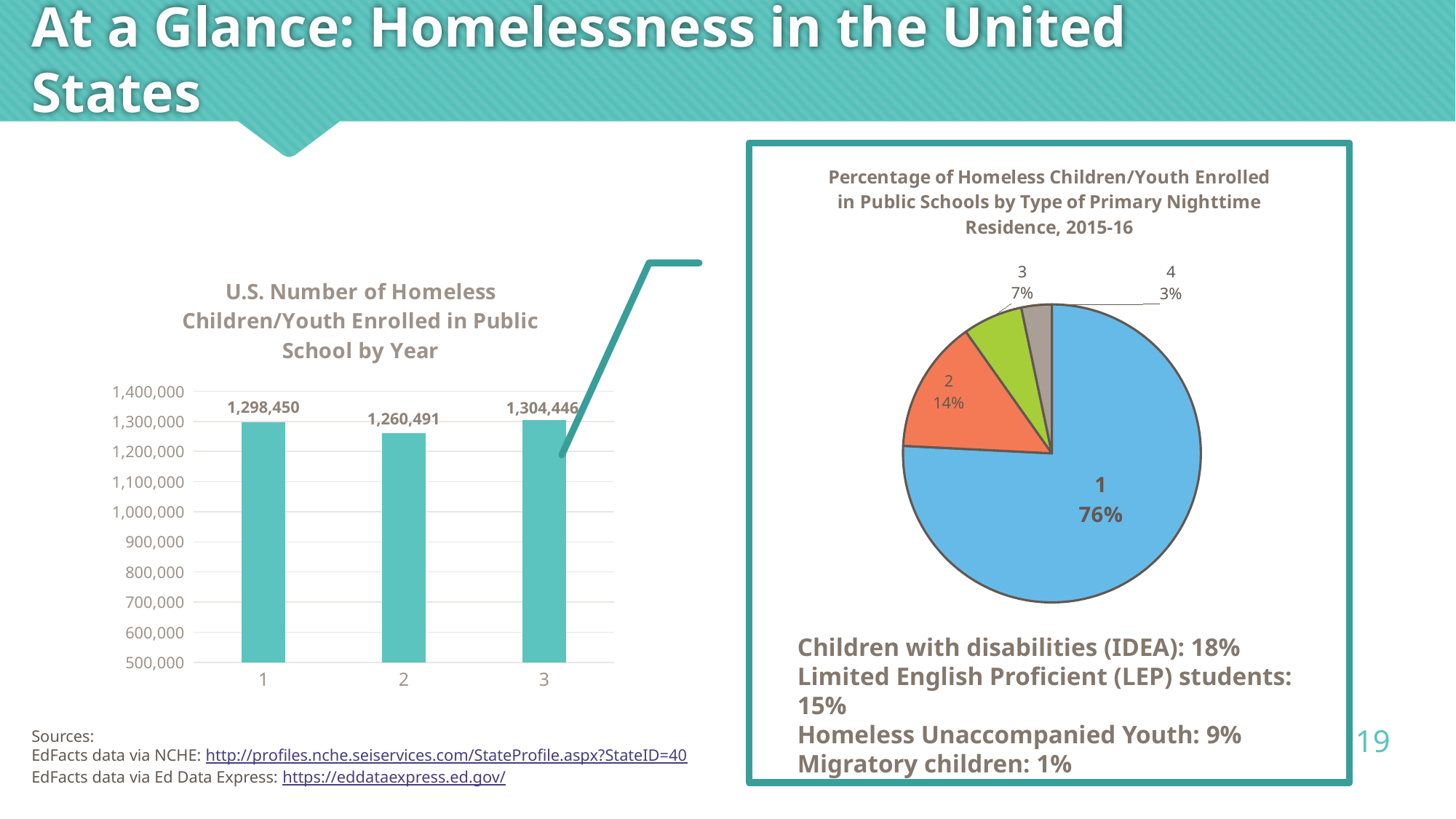
In the bar chart 'U.S. Number of Homeless Children/Youth Enrolled in Public School by Year', what is the value for category 2? 1,260,491 In the bar chart 'U.S. Number of Homeless Children/Youth Enrolled in Public School by Year', how many bars are plotted? 3 What type of chart is the chart on the left of the slide? Bar chart In the pie chart 'Percentage of Homeless Children/Youth Enrolled in Public Schools by Type of Primary Nighttime Residence, 2015-16', which slice is the smallest? 4 In the pie chart 'Percentage of Homeless Children/Youth Enrolled in Public Schools by Type of Primary Nighttime Residence, 2015-16', how many slices are there? 4 In the bar chart 'U.S. Number of Homeless Children/Youth Enrolled in Public School by Year', which category has the highest value? 3 In the pie chart 'Percentage of Homeless Children/Youth Enrolled in Public Schools by Type of Primary Nighttime Residence, 2015-16', what is the difference between slice 2 and slice 4? 11% In the pie chart 'Percentage of Homeless Children/Youth Enrolled in Public Schools by Type of Primary Nighttime Residence, 2015-16', what is the value for slice 3? 7% In the bar chart 'U.S. Number of Homeless Children/Youth Enrolled in Public School by Year', what is the value for category 1? 1,298,450 In the pie chart 'Percentage of Homeless Children/Youth Enrolled in Public Schools by Type of Primary Nighttime Residence, 2015-16', what share does slice 1 have? 76% In the bar chart 'U.S. Number of Homeless Children/Youth Enrolled in Public School by Year', what is the difference between the values for category 3 and category 2? 43,955 In the bar chart 'U.S. Number of Homeless Children/Youth Enrolled in Public School by Year', which category has the lowest value? 2